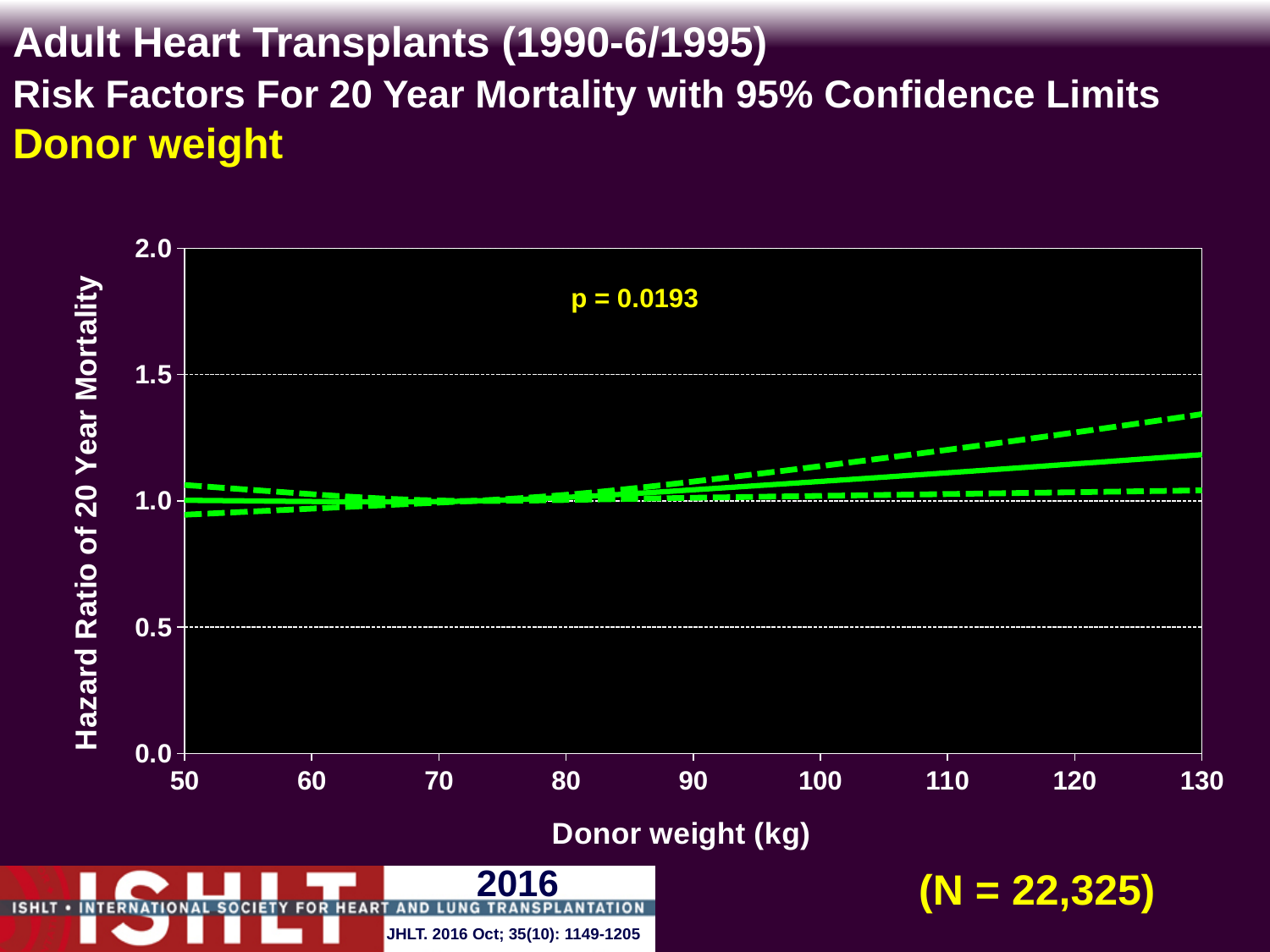
What sample size (N) is shown on the slide? N = 22,325 Is the hazard ratio at a donor weight of 110 kg greater or less than 0.5? greater Is the hazard ratio higher at a donor weight of 130 kg or at 60 kg? 130 kg What kind of chart is shown on the slide? line chart What p-value is printed on the chart? p = 0.0193 Is the hazard ratio at a donor weight of 130 kg greater or less than 1.5? less Is the hazard ratio at a donor weight of 130 kg greater or less than 1.0? greater Does the hazard ratio of 20 year mortality rise or fall as donor weight increases from 50 kg to 130 kg? rise